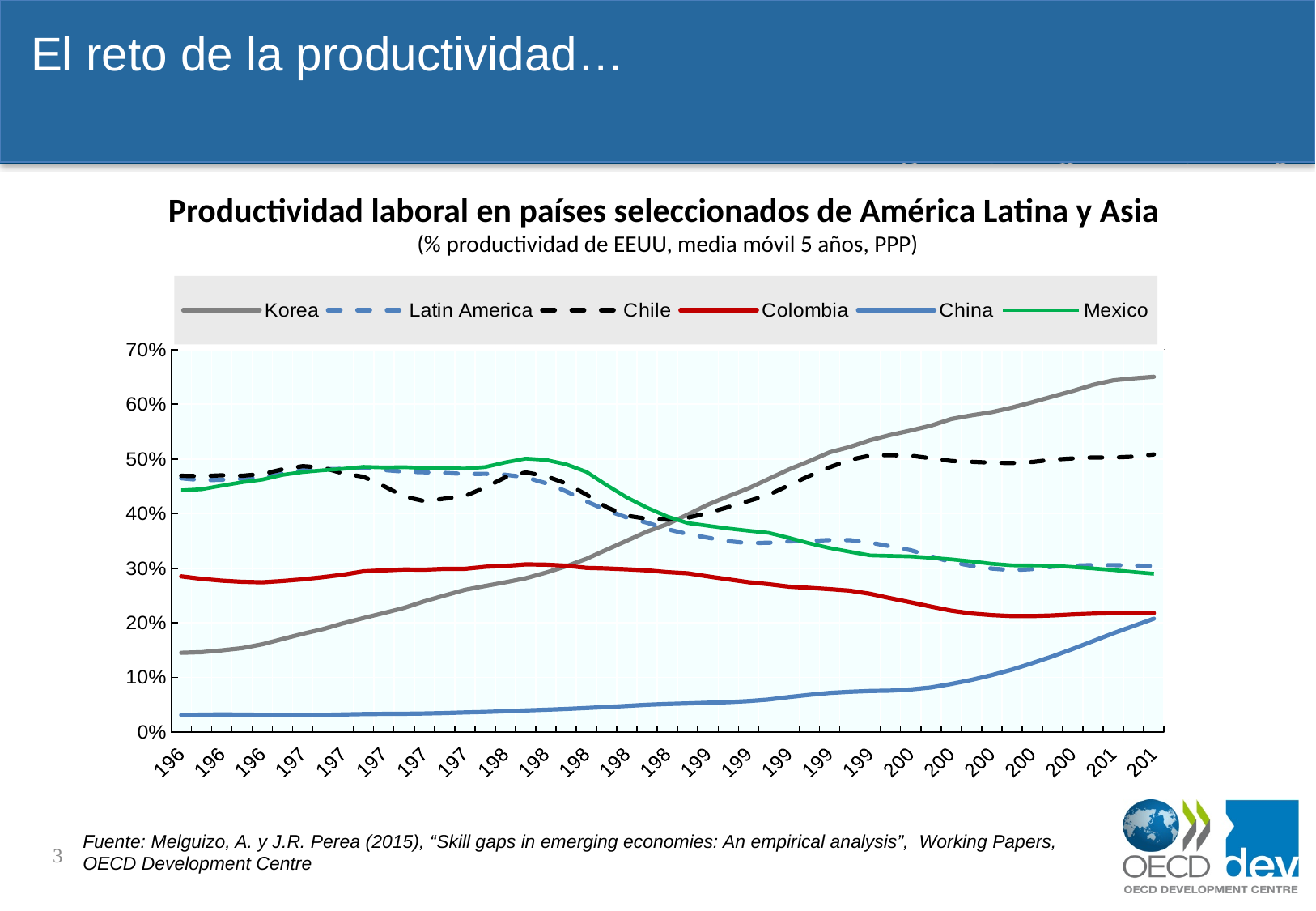
Which series is plotted with a solid grey line? Korea Which series has the lowest value at the start of the period? China Does the value for China rise or fall over the period shown? rise Which series has the highest value at the end of the period? Korea Is the value for Korea at the end of the period greater or less than 60%? greater What kind of chart is shown on the slide? line chart Is the value for Chile at the end of the period greater or less than 40%? greater What is the title of the chart? Productividad laboral en países seleccionados de América Latina y Asia How many series does the legend list? 6 Is the value for China at the start of the period greater or less than 10%? less Does the value for Korea rise or fall over the period shown? rise Does the value for Colombia rise or fall over the period shown? fall